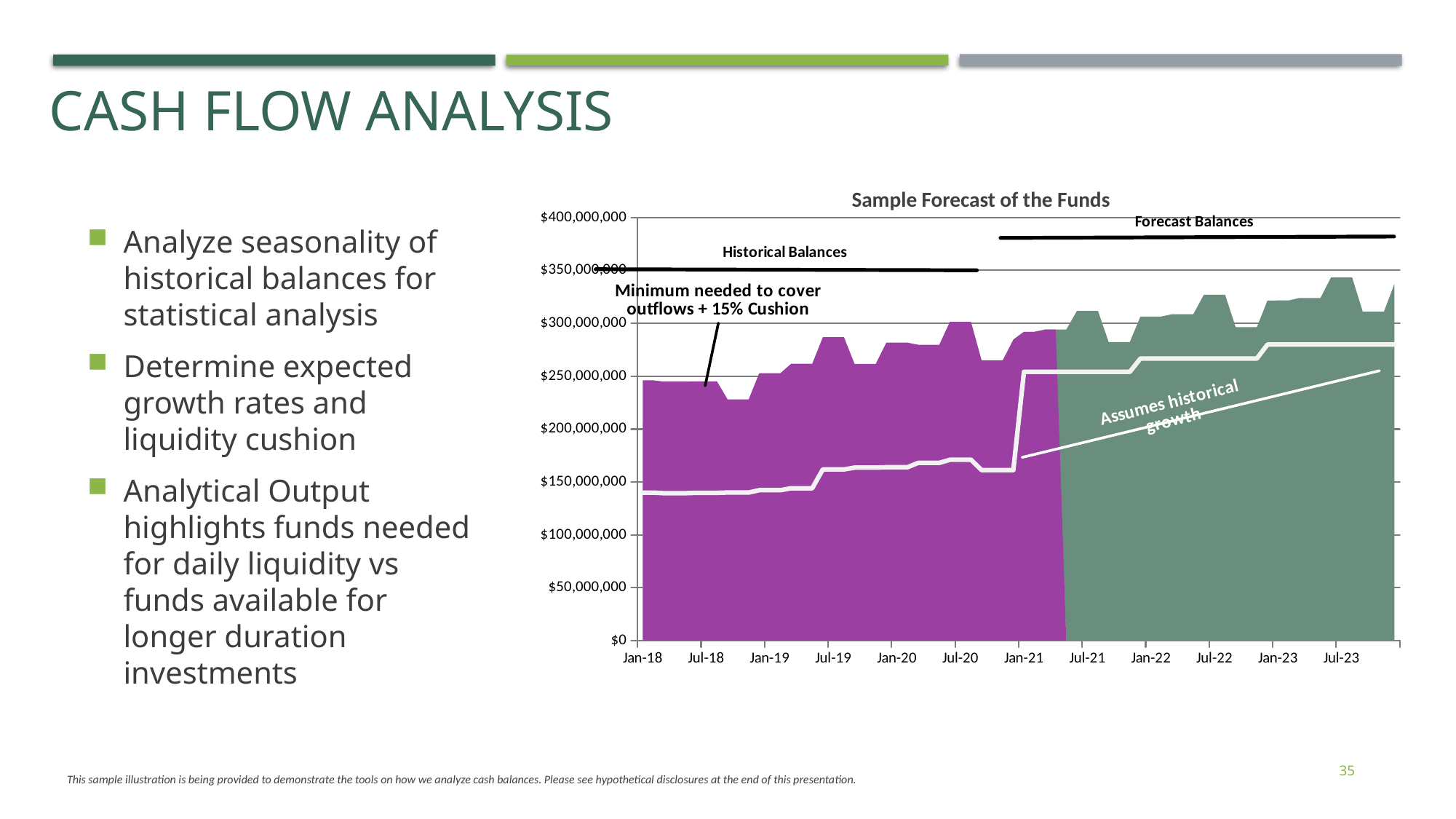
Is the balance at Jul-18 greater or less than $300,000,000? less Does the 'Minimum needed to cover outflows + 15% Cushion' line rise or fall over the period shown? rise Is the 'Minimum needed to cover outflows + 15% Cushion' line at Jan-18 greater or less than $150,000,000? less What kind of chart is shown on the slide? area chart Is the balance at Jan-18 greater or less than $200,000,000? greater Do the balances generally rise or fall from Jan-18 to Jul-23? rise Which label is used for the green shaded portion of the chart? Forecast Balances What is the title of the chart? Sample Forecast of the Funds How many date labels are shown on the x axis? 12